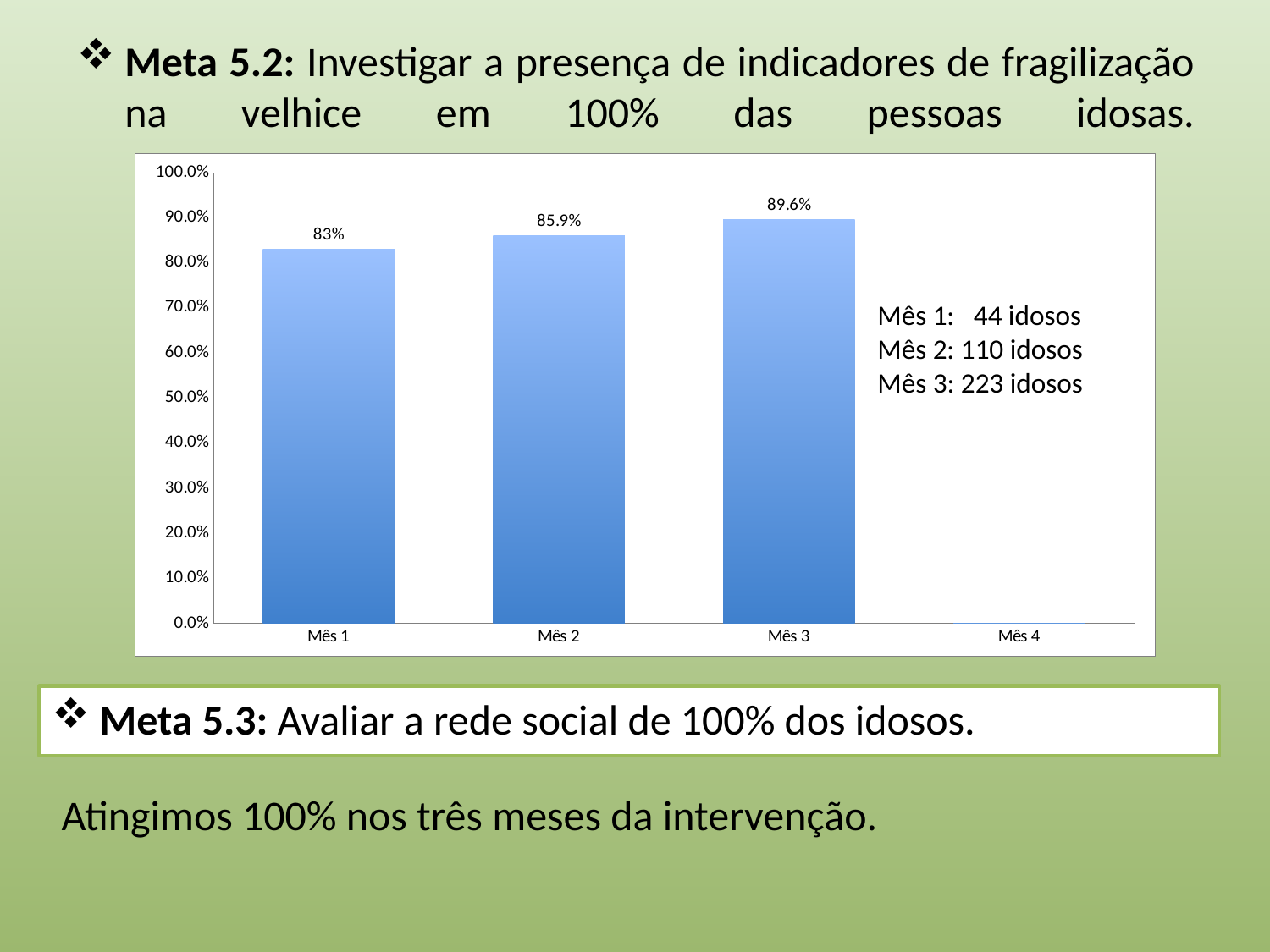
Is the value for Mês 1 greater or less than 80.0%? greater Do the bar values rise or fall from Mês 1 to Mês 3? rise What is the difference in percentage points between the values for Mês 2 and Mês 1? 2.9 What is the value shown for Mês 2? 85.9% Among the three months with labelled bars, which has the lowest value? Mês 1 What is the value shown for Mês 1? 83% What kind of chart is shown on the slide? bar chart How many categories are shown on the x axis of the chart? 4 Which is larger, the value for Mês 2 or the value for Mês 3? Mês 3 What is the value shown for Mês 3? 89.6% What is the difference in percentage points between the values for Mês 3 and Mês 1? 6.6 Which month has the highest bar in the chart? Mês 3